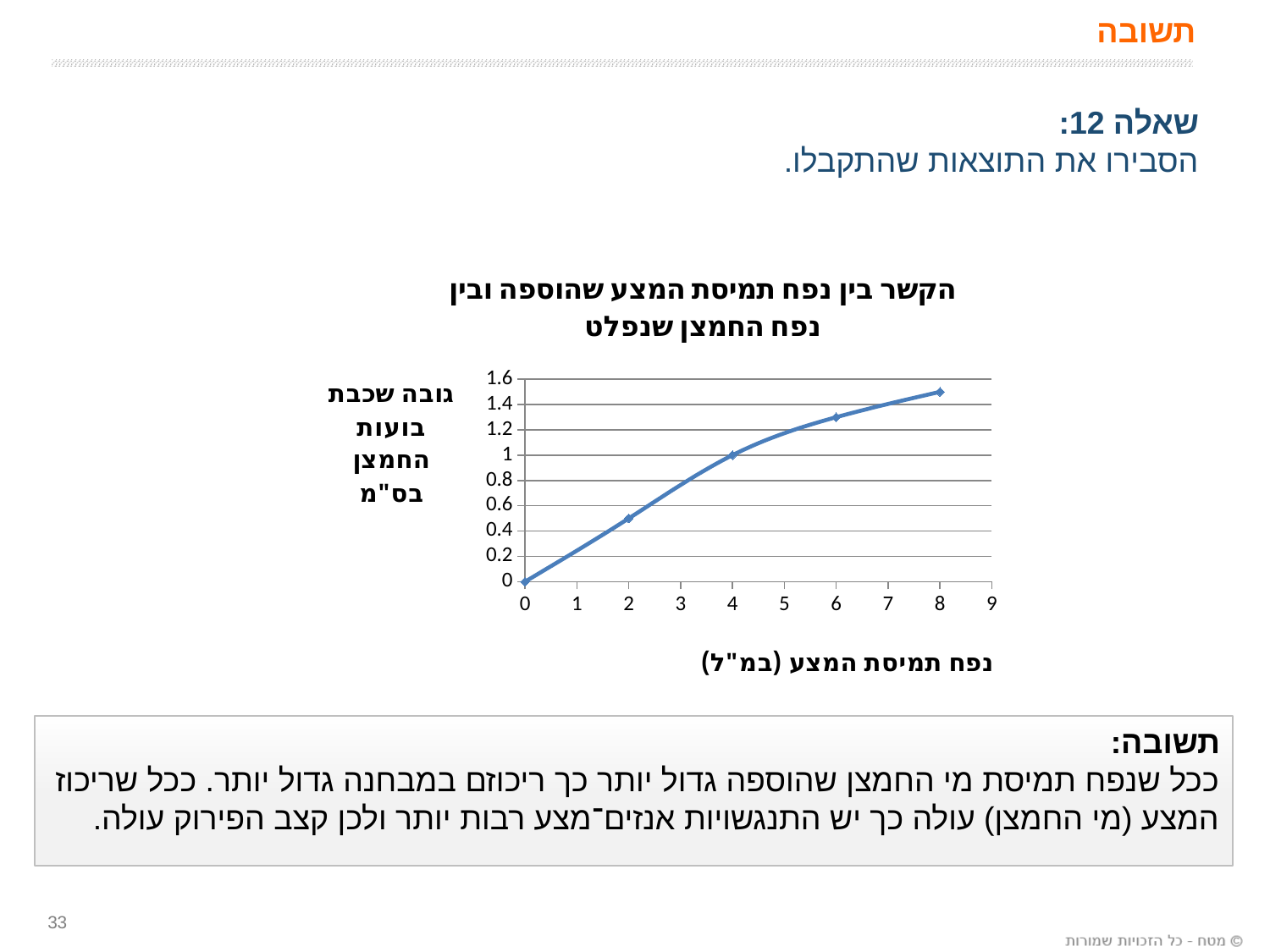
Is the value at 2 ml of substrate solution greater or less than 0.6? less Which is larger: the value at 4 ml or the value at 6 ml? 6 ml What is the height of the oxygen bubble layer when the substrate solution volume is 4 ml? 1 What is the label of the x axis of the chart? נפח תמיסת המצע (במ"ל) What is the height of the oxygen bubble layer when the substrate solution volume is 0 ml? 0 How many data points are plotted on the chart? 5 What kind of chart is shown on the slide? line chart At which substrate solution volume is the bubble layer height highest? 8 Do the values rise or fall as the volume of substrate solution (x axis) increases? rise Is the value at 6 ml of substrate solution greater or less than 1.2? greater Is the value at 8 ml of substrate solution greater or less than 1.4? greater At which substrate solution volume is the bubble layer height lowest? 0